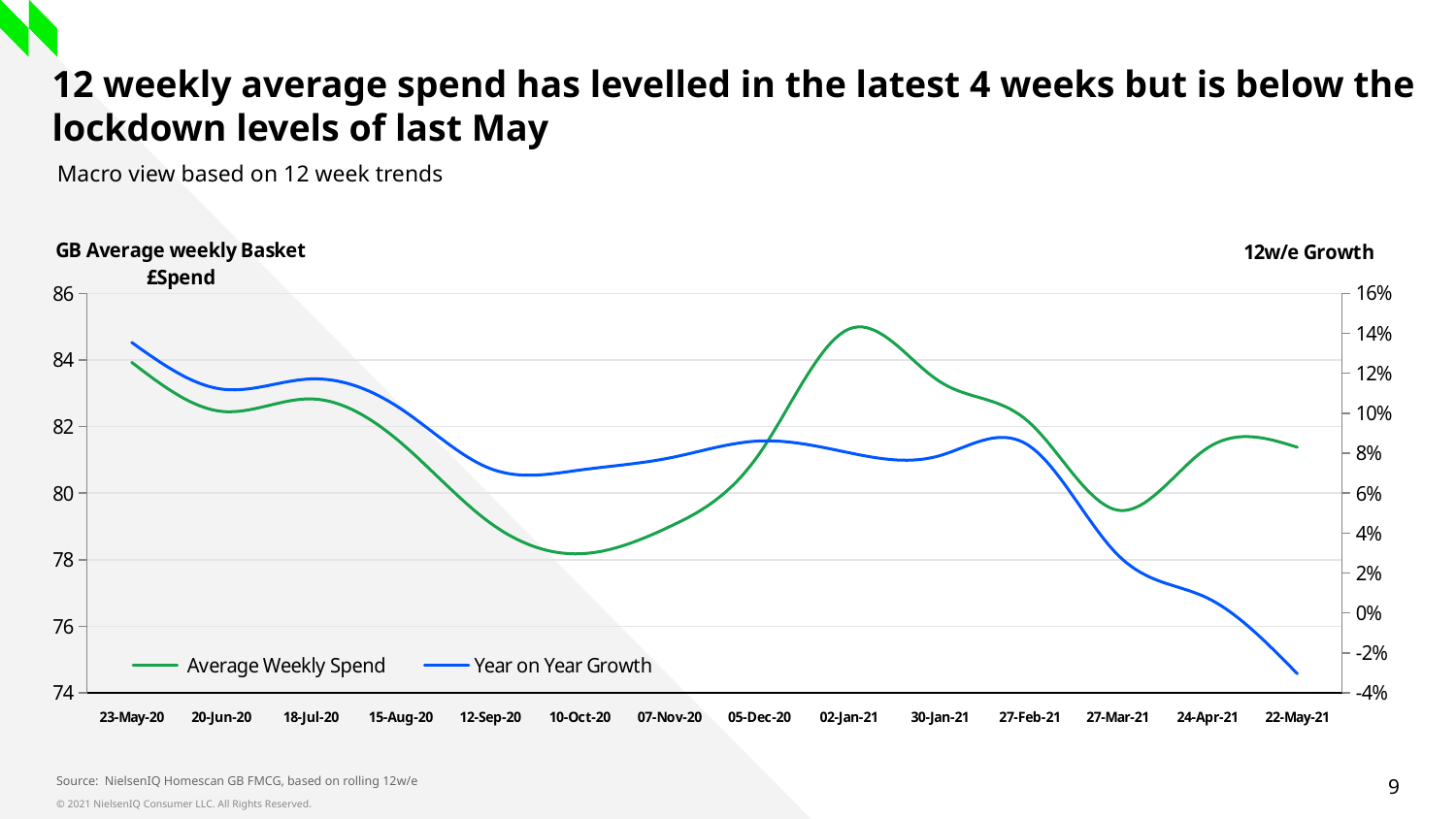
What is the title of the right-hand axis? 12w/e Growth Is the Year on Year Growth value at 22-May-21 greater or less than 0%? less How many series does the legend list? 2 Is the Average Weekly Spend value at 10-Oct-20 greater or less than 80? less Which is larger: the Average Weekly Spend at 23-May-20 or at 22-May-21? 23-May-20 What kind of chart is shown on the slide? Line chart Is the Year on Year Growth value at 23-May-20 greater or less than 12%? greater Does the Year on Year Growth line rise or fall between 27-Feb-21 and 22-May-21? fall How many date labels are shown on the x axis? 14 At which x-axis date does the Year on Year Growth line reach its lowest point? 22-May-21 At which x-axis date does the Average Weekly Spend line reach its highest point? 02-Jan-21